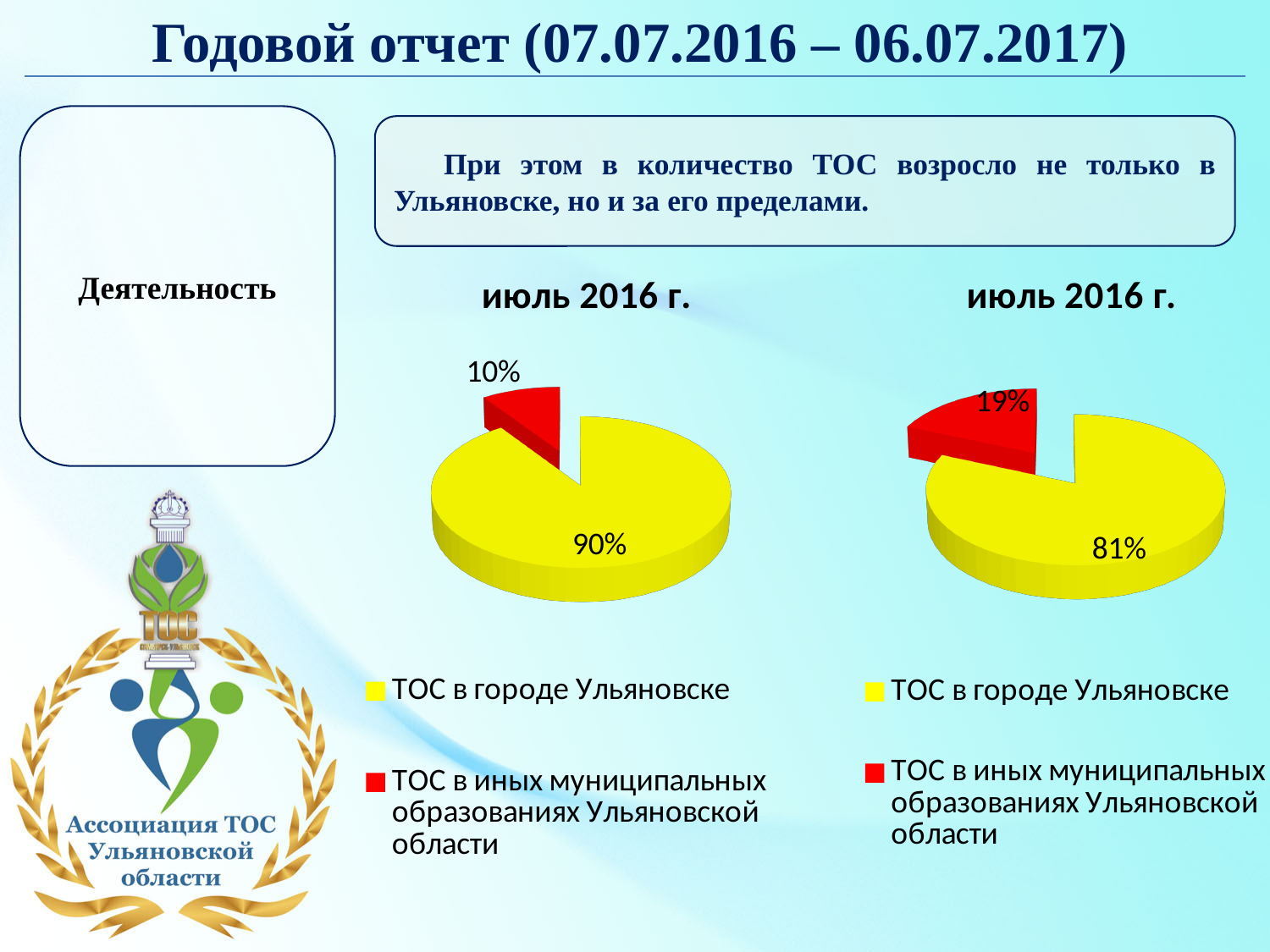
In the left pie chart, what share is labelled for ТОС в городе Ульяновске? 90% In the right pie chart, what share is labelled for ТОС в иных муниципальных образованиях Ульяновской области? 19% In the right pie chart, what is the difference in percentage points between the two slices? 62 What type of chart is shown on the right side of the slide? pie chart In the left pie chart, what share is labelled for ТОС в иных муниципальных образованиях Ульяновской области? 10% What colour is the slice for ТОС в городе Ульяновске in the left pie chart? yellow Which is larger: the red slice in the left pie chart or the red slice in the right pie chart? the red slice in the right pie chart How many slices does the left pie chart have? 2 In the right pie chart, which category has the smallest slice? ТОС в иных муниципальных образованиях Ульяновской области In the right pie chart, what share is labelled for ТОС в городе Ульяновске? 81% In the left pie chart, which category has the largest slice? ТОС в городе Ульяновске How many entries does the legend of the right pie chart list? 2